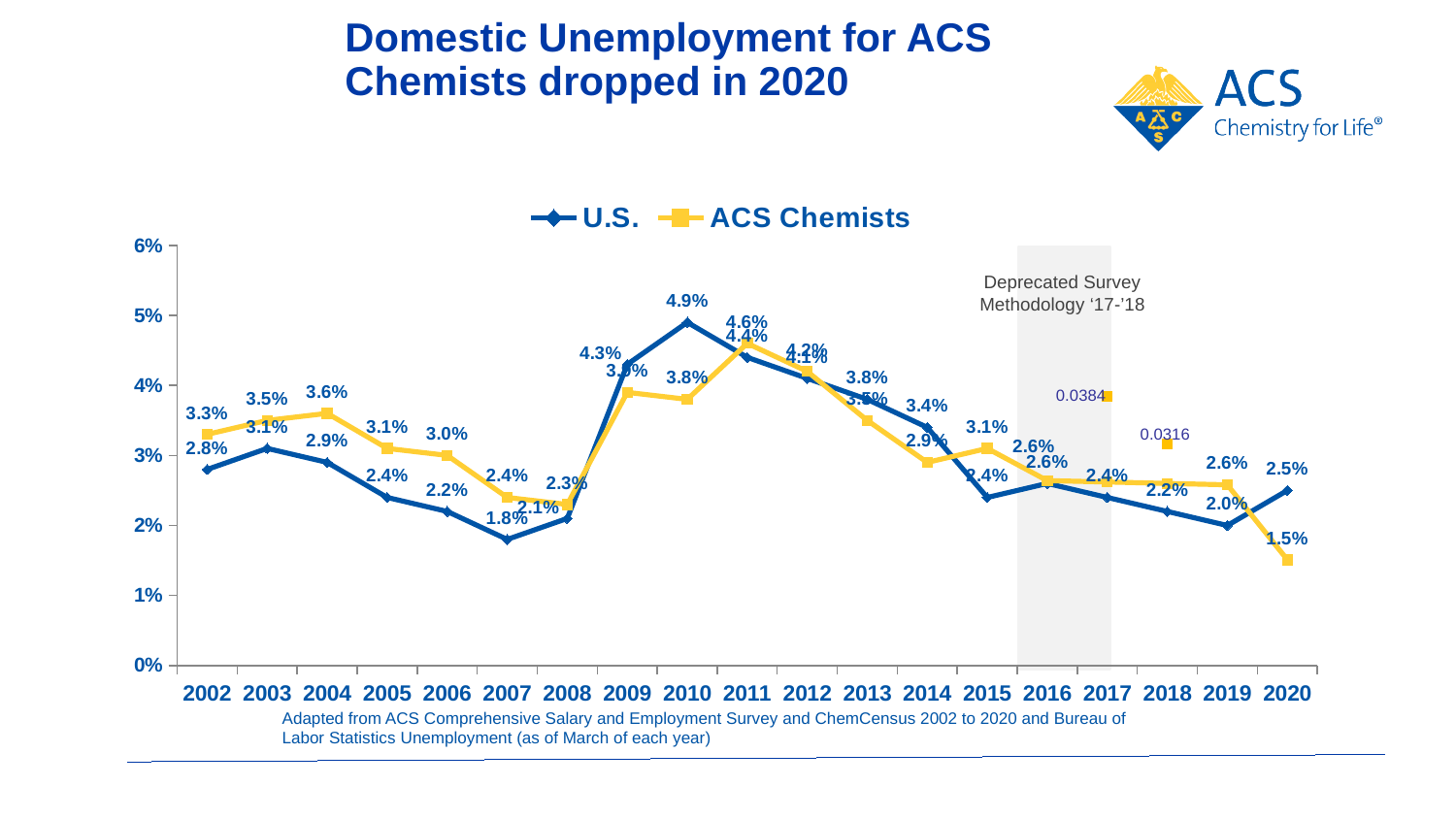
What was the U.S. unemployment rate in 2010? 4.9% How many years are shown on the x axis? 19 Is the ACS Chemists value for 2017 greater or less than 4%? less In 2014, which was higher: the U.S. rate or the ACS Chemists rate? U.S. What was the ACS Chemists unemployment rate in 2011? 4.6% How many series does the legend list? 2 What is the difference between the U.S. rate and the ACS Chemists rate in 2020? 1.0 percentage point In which year was the U.S. unemployment rate lowest? 2007 What type of chart is shown on the slide? Line chart What was the ACS Chemists unemployment rate in 2020? 1.5% In which year was the ACS Chemists unemployment rate lowest? 2020 In which year was the U.S. unemployment rate highest? 2010